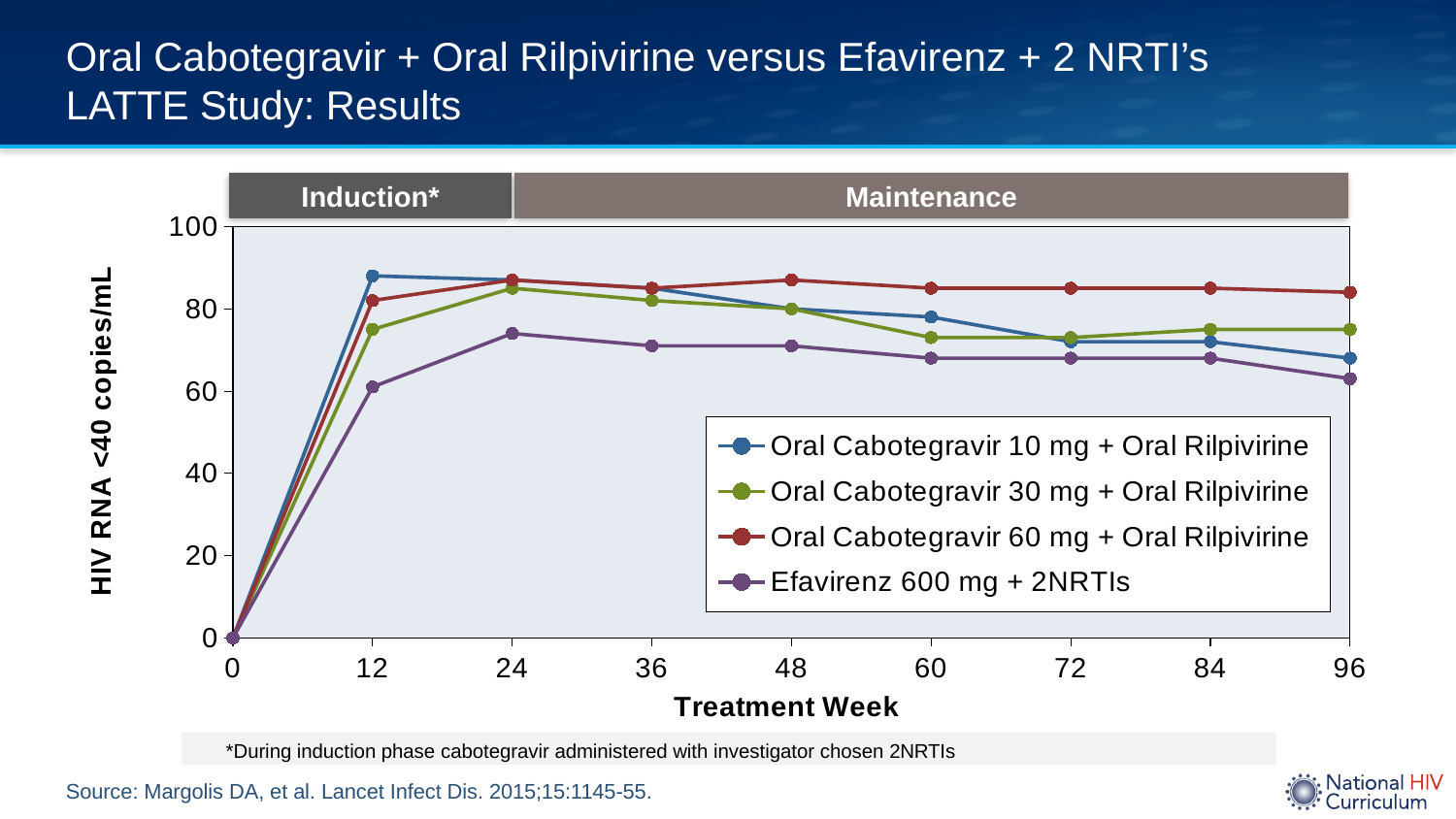
What are the two study phases labelled above the chart? Induction* and Maintenance Does the Oral Cabotegravir 10 mg + Oral Rilpivirine line rise or fall from week 12 to week 96? Fall At week 96, which is larger: Oral Cabotegravir 60 mg + Oral Rilpivirine or Oral Cabotegravir 10 mg + Oral Rilpivirine? Oral Cabotegravir 60 mg + Oral Rilpivirine At week 12, which is larger: Oral Cabotegravir 10 mg + Oral Rilpivirine or Efavirenz 600 mg + 2NRTIs? Oral Cabotegravir 10 mg + Oral Rilpivirine Which series has the lowest value at week 12? Efavirenz 600 mg + 2NRTIs What kind of chart is shown on the slide? Line chart Is the value for Efavirenz 600 mg + 2NRTIs at week 24 greater or less than 80? less Which series has the highest value at week 96? Oral Cabotegravir 60 mg + Oral Rilpivirine Is the value for Efavirenz 600 mg + 2NRTIs at week 60 greater or less than 60? greater Is the value for Oral Cabotegravir 60 mg + Oral Rilpivirine at week 48 greater or less than 80? greater How many treatment weeks are marked on the x axis? 9 How many series does the legend list? 4